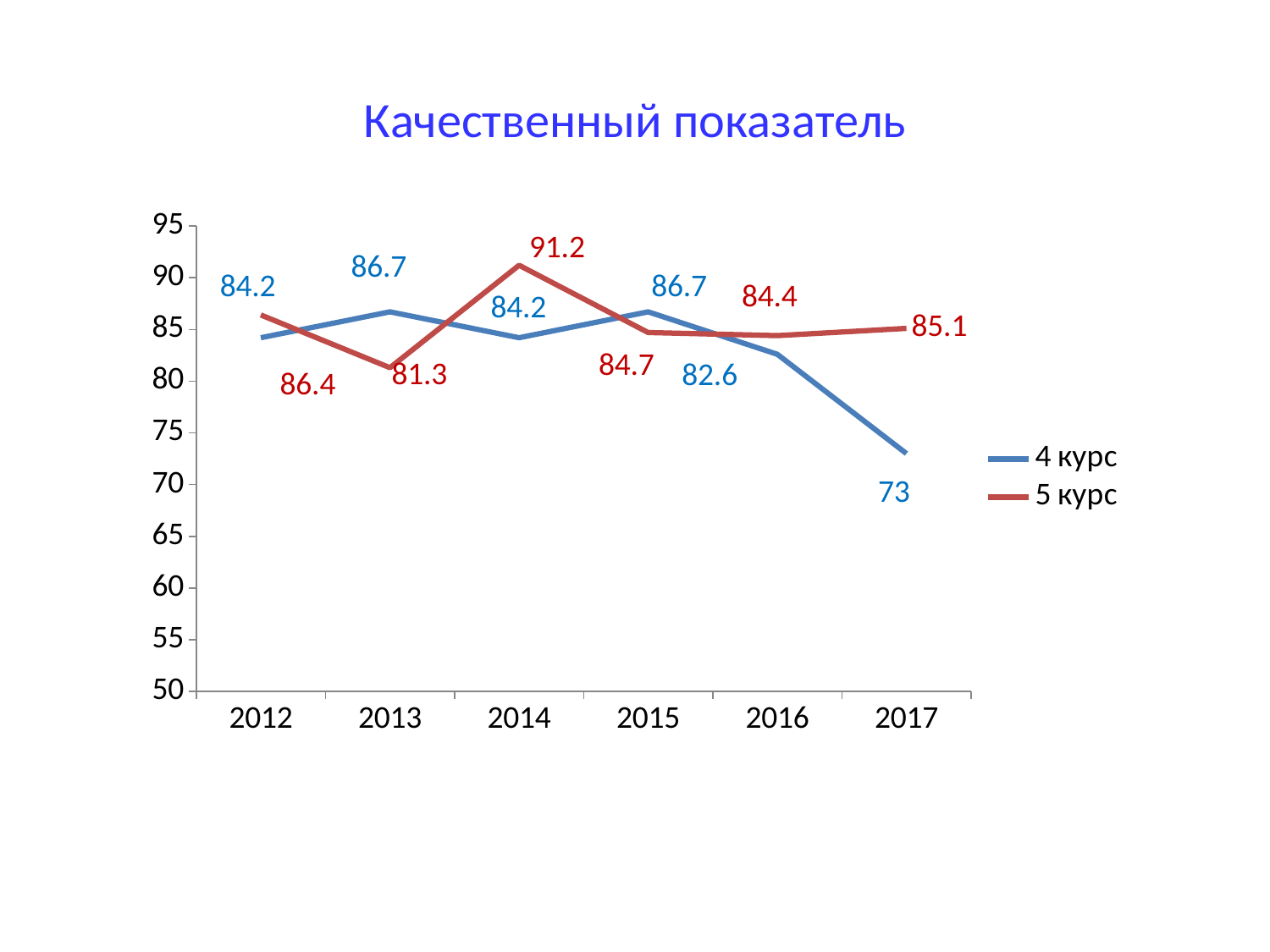
Which series has the larger value in 2013, 4 курс or 5 курс? 4 курс What is the title of the chart? Качественный показатель Does the value for 4 курс rise or fall from 2015 to 2017? fall What is the value for 5 курс in 2013? 81.3 In which year is the value for 4 курс lowest? 2017 What is the value for 4 курс in 2017? 73 How many years are shown on the x axis? 6 How many series does the legend list? 2 What is the difference between 5 курс and 4 курс in 2017? 12.1 What is the value for 5 курс in 2014? 91.2 What type of chart is shown on the slide? line chart In which year is the value for 5 курс highest? 2014